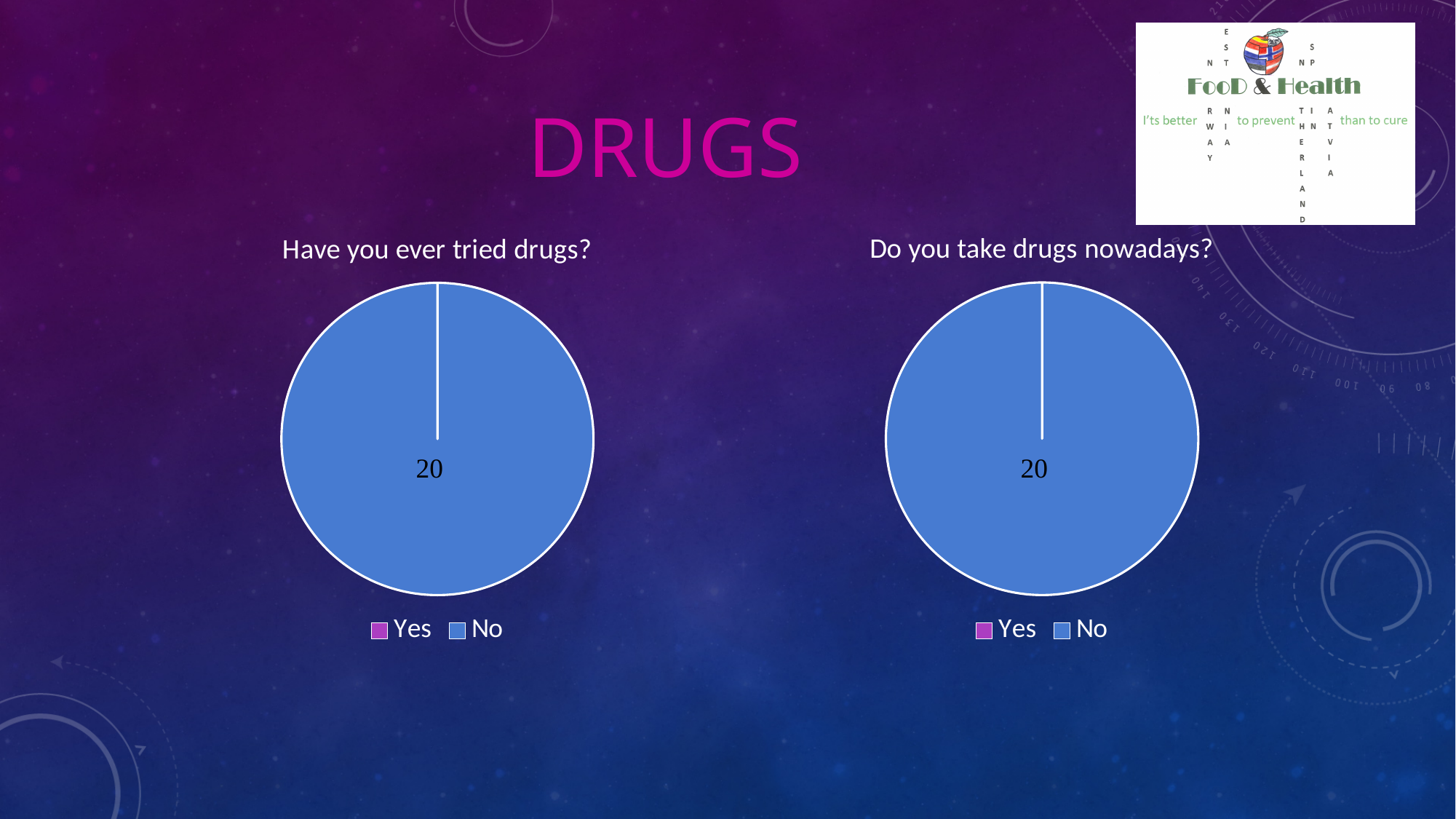
In the chart titled "Do you take drugs nowadays?", what value is shown for No? 20 What kind of chart is the left chart, "Have you ever tried drugs?"? Pie chart What is the title of the chart on the right side of the slide? Do you take drugs nowadays? In the chart titled "Have you ever tried drugs?", which is larger, Yes or No? No In the chart titled "Do you take drugs nowadays?", which is larger, Yes or No? No How many entries does the legend of the left chart, "Have you ever tried drugs?", list? 2 In the chart titled "Do you take drugs nowadays?", which category has the largest slice? No In the chart titled "Have you ever tried drugs?", what value is shown for No? 20 What are the legend entries of the chart titled "Have you ever tried drugs?"? Yes, No How many entries does the legend of the right chart, "Do you take drugs nowadays?", list? 2 In the chart titled "Have you ever tried drugs?", which category has the largest slice? No What kind of chart is the right chart, "Do you take drugs nowadays?"? Pie chart